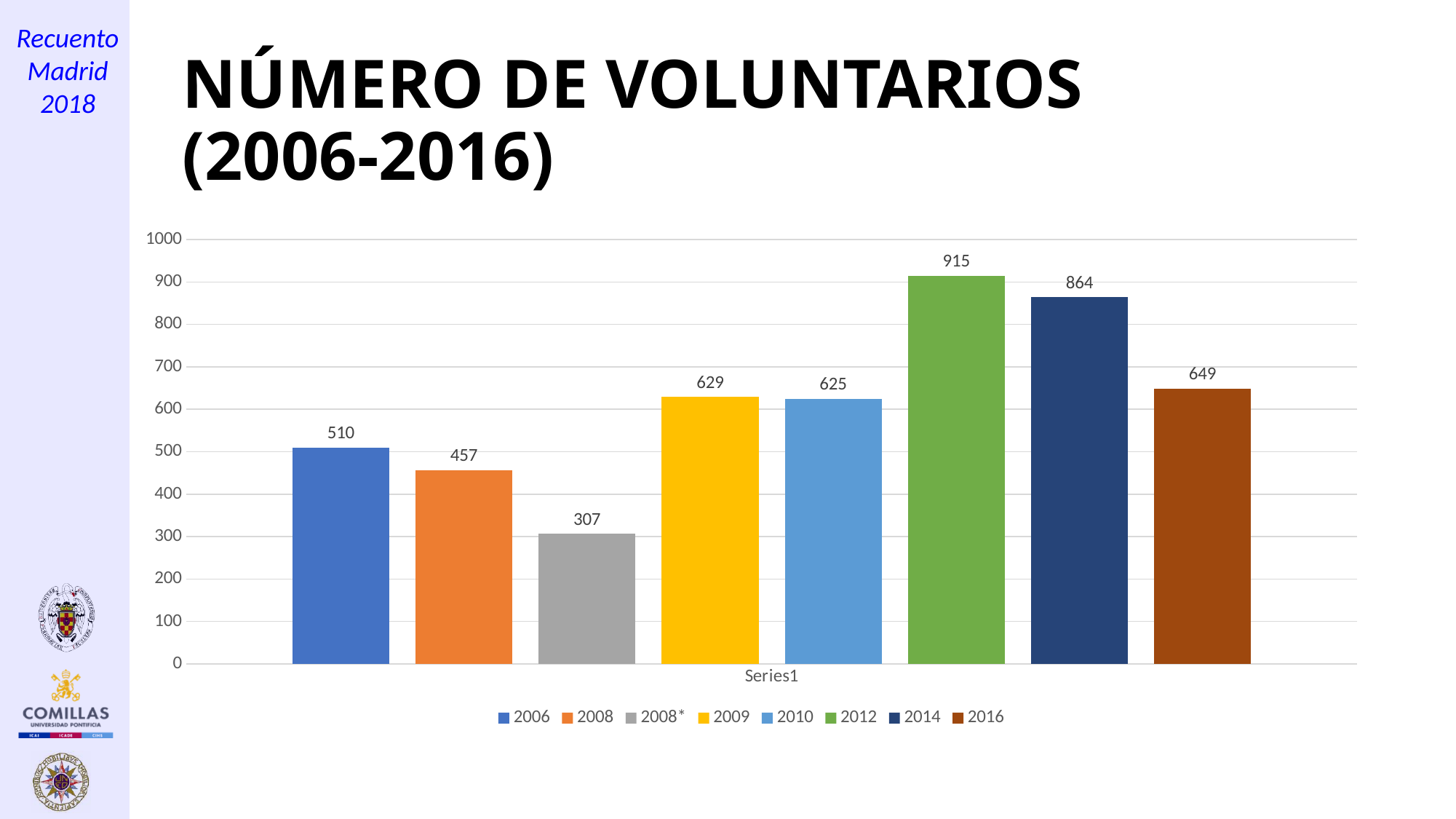
What is the number of volunteers for 2016? 649 What is the number of volunteers for 2008*? 307 What kind of chart is shown on the slide? Bar chart What is the difference between the number of volunteers in 2006 and 2008? 53 What is the title of the chart on the slide? NÚMERO DE VOLUNTARIOS (2006-2016) Which year has the highest number of volunteers? 2012 How many bars are shown in the chart? 8 Which year has the lowest number of volunteers? 2008* Which has more volunteers, 2014 or 2016? 2014 What is the number of volunteers for 2012? 915 What is the difference between the number of volunteers in 2012 and 2014? 51 Is the value for 2010 greater or less than 600? greater